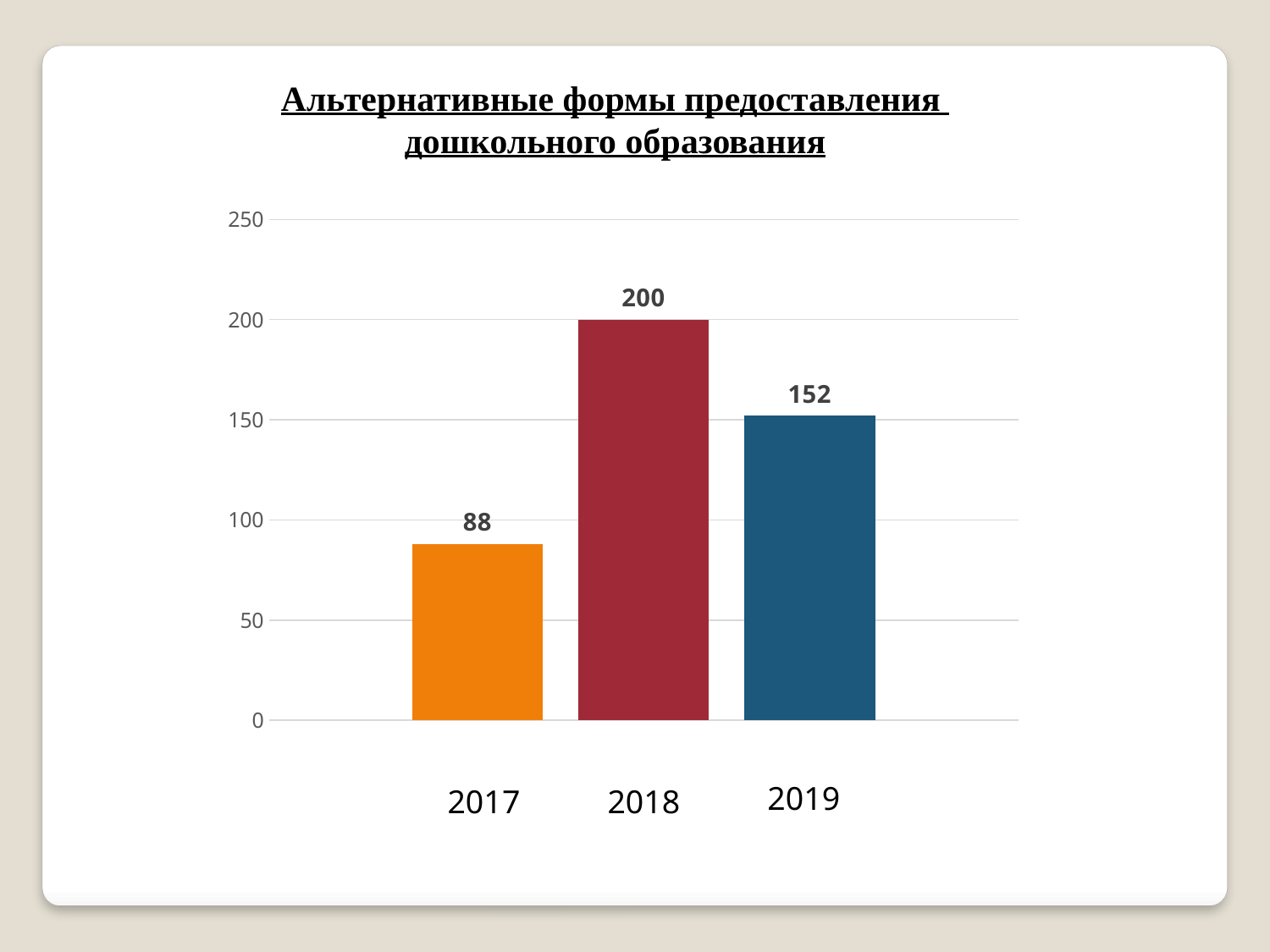
What is the difference between the values for 2018 and 2017? 112 What is the value for 2017? 88 What is the value for 2019? 152 What is the title of the chart? Альтернативные формы предоставления дошкольного образования Which is larger, the value for 2017 or the value for 2019? 2019 What is the difference between the values for 2018 and 2019? 48 Which year has the highest value? 2018 Is the value for 2017 greater or less than 100? less Which year has the lowest value? 2017 What is the value for 2018? 200 How many years are shown on the chart? 3 What kind of chart is shown on the slide? bar chart